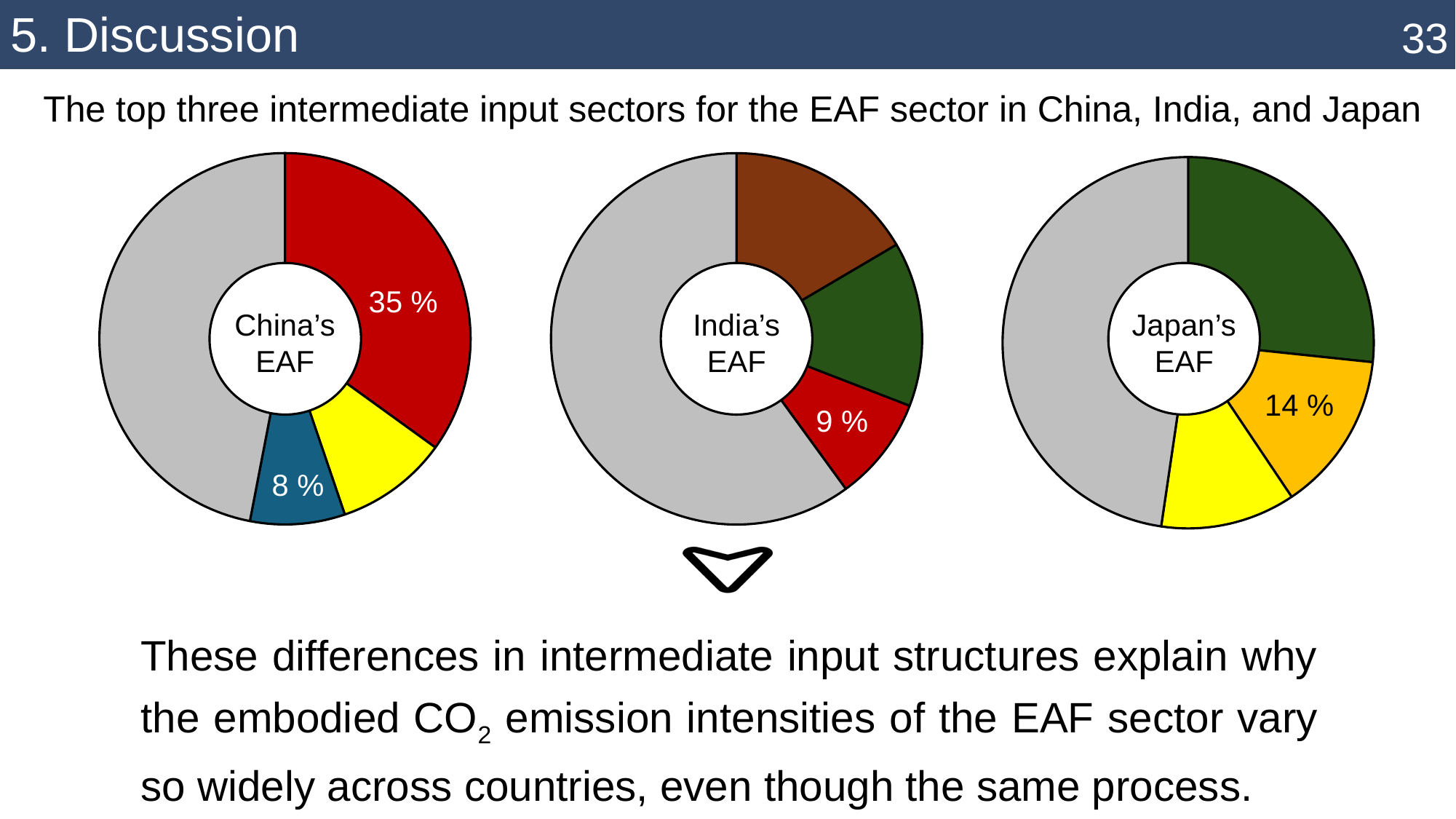
How many charts are shown on the slide? 3 In the China's EAF chart, what share is shown for the red slice? 35 % Which is larger: the orange slice in the Japan's EAF chart or the red slice in the India's EAF chart? the orange slice in Japan's EAF In the China's EAF chart, which is larger, the red slice or the blue slice? the red slice How many slices does each of the three charts have, including the grey remainder? 4 What kind of chart is used for China's EAF, India's EAF, and Japan's EAF? pie chart In the India's EAF chart, what share is shown for the red slice? 9 % In the China's EAF chart, what is the difference between the red slice and the blue slice? 27 % What text is written in the centre of the middle chart? India's EAF In the China's EAF chart, what share is shown for the blue slice? 8 % In the Japan's EAF chart, what share is shown for the orange slice? 14 % In the India's EAF chart, which of the non-grey slices is the largest? the brown slice